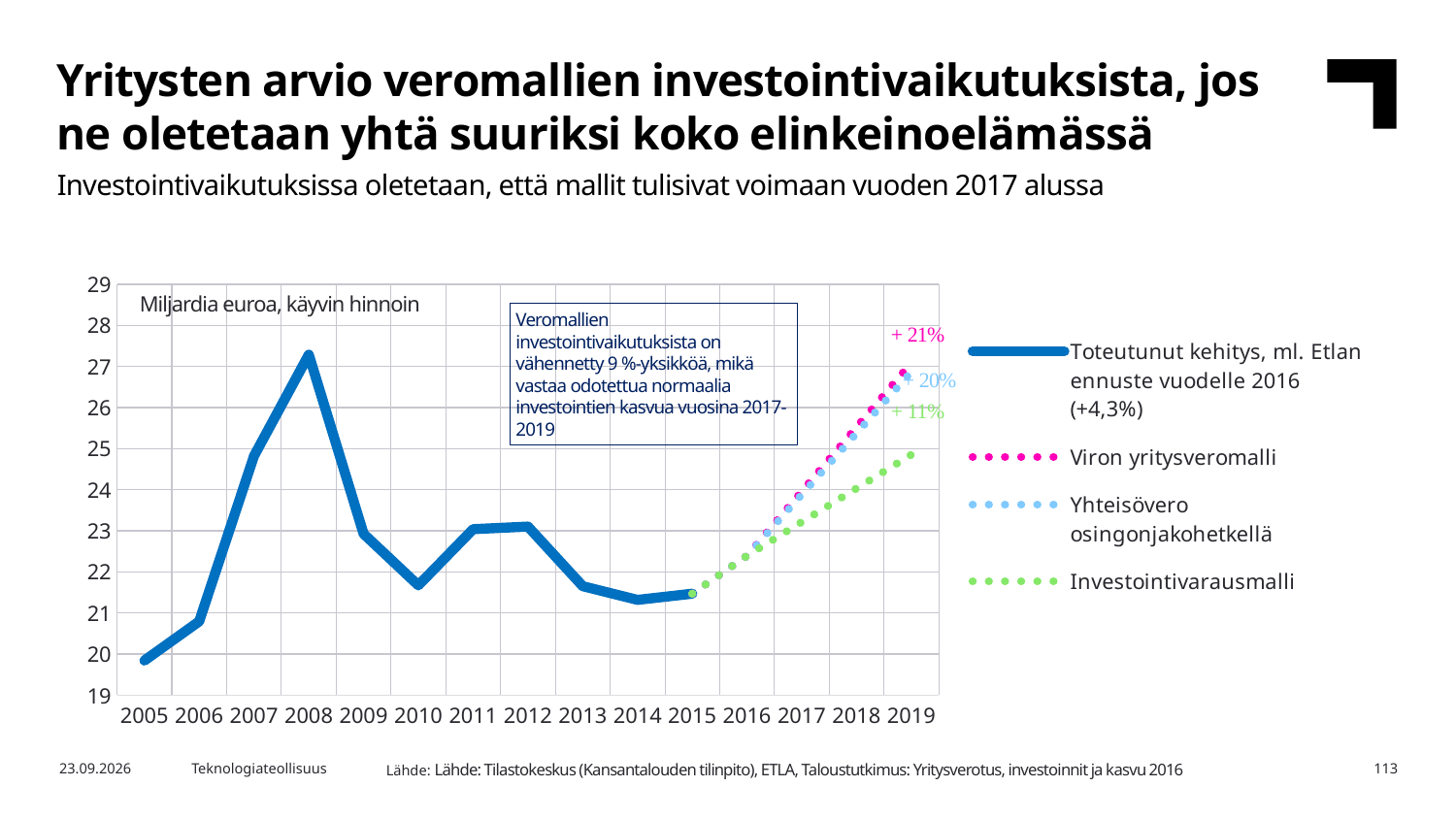
In which year is the Toteutunut kehitys line at its lowest value? 2005 Is the Toteutunut kehitys value for 2014 greater or less than 22? less Which is larger for Toteutunut kehitys: the value in 2008 or the value in 2011? 2008 In which year does the Toteutunut kehitys line reach its highest value? 2008 Is the Toteutunut kehitys value for 2008 greater or less than 26? greater How many series does the legend list? 4 What percentage increase is labelled for the Viron yritysveromalli series? + 21% Which projected series ends lowest in 2019? Investointivarausmalli What kind of chart is shown on the slide? line chart Does the Toteutunut kehitys line rise or fall from 2008 to 2009? fall How many years are shown on the x axis? 15 Is the Investointivarausmalli value for 2019 greater or less than 26? less